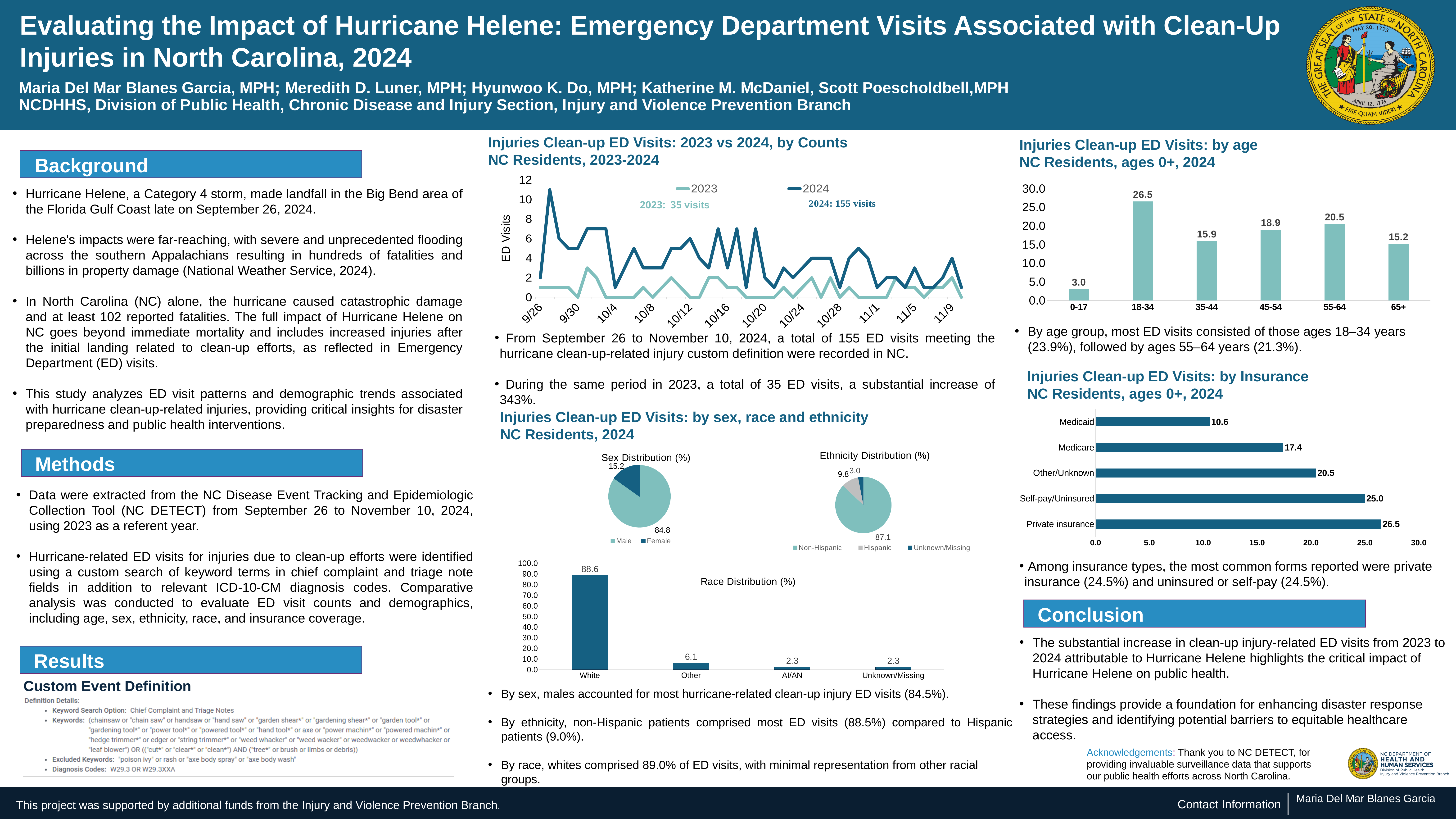
In the 'Ethnicity Distribution (%)' pie chart, what is the value for Hispanic? 9.8 In the 'Injuries Clean-up ED Visits: by age' chart, what is the value for the 18-34 age group? 26.5 How many series does the legend list in the 'Injuries Clean-up ED Visits: 2023 vs 2024, by Counts' chart? 2 What kind of chart is 'Injuries Clean-up ED Visits: 2023 vs 2024, by Counts'? Line chart In the 'Injuries Clean-up ED Visits: by age' chart, which age group has the lowest value? 0-17 In the 'Sex Distribution (%)' pie chart, what share is Female? 15.2 In the 'Injuries Clean-up ED Visits: by age' chart, how many age groups are shown? 6 In the 'Injuries Clean-up ED Visits: by Insurance' chart, what is the value for Medicare? 17.4 In the 'Race Distribution (%)' chart, what is the value for Other? 6.1 In the 'Injuries Clean-up ED Visits: by Insurance' chart, which is larger, Self-pay/Uninsured or Other/Unknown? Self-pay/Uninsured In the 'Injuries Clean-up ED Visits: by age' chart, what is the difference between the 55-64 and 35-44 age groups? 4.6 In the 'Injuries Clean-up ED Visits: by Insurance' chart, which insurance type has the highest value? Private insurance